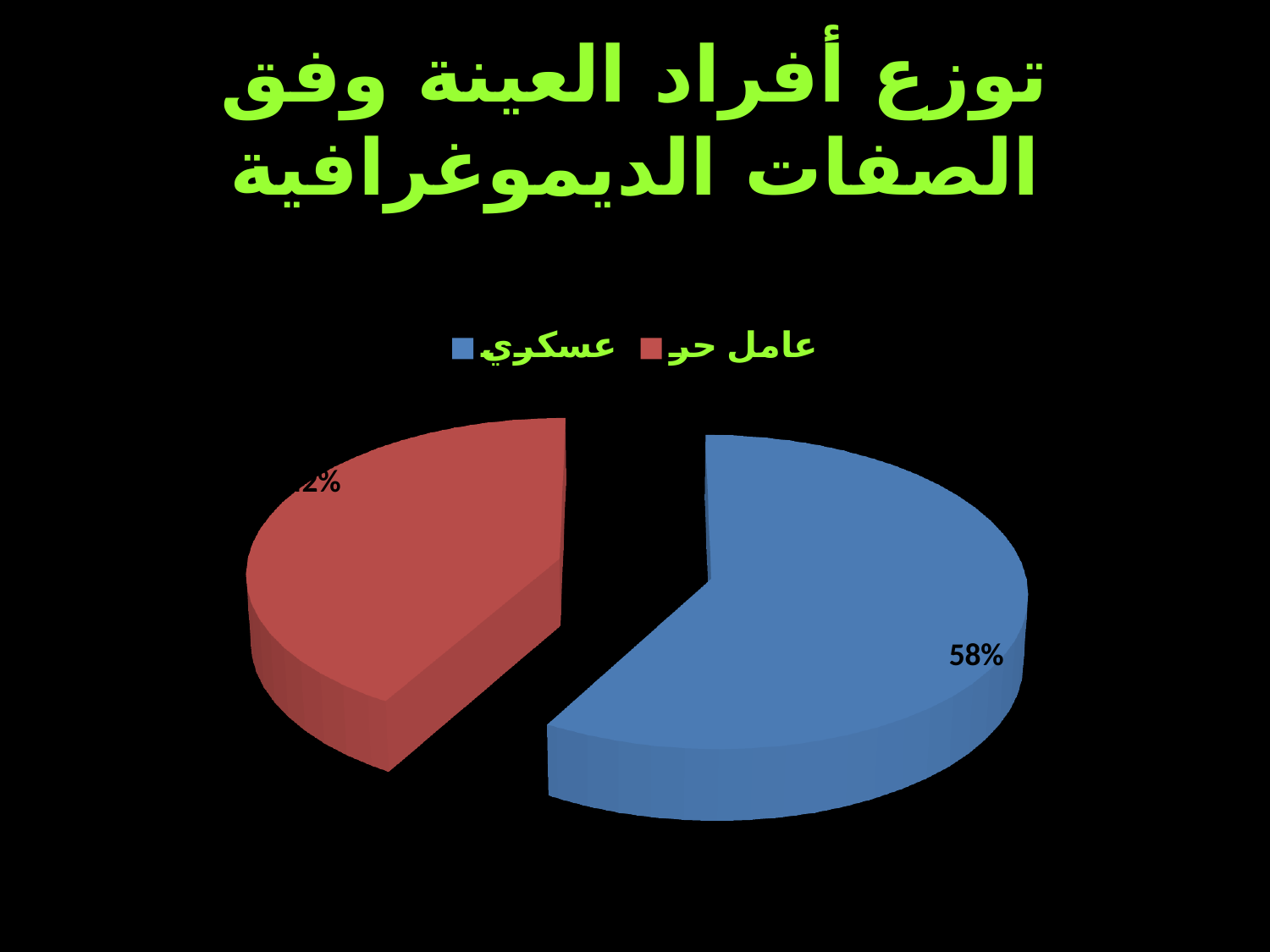
Which slice is larger, عسكري or عامل حر? عسكري Which category has the smallest slice of the pie? عامل حر What share of the pie is taken by عسكري? 58% What is the title of the slide? توزع أفراد العينة وفق الصفات الديموغرافية How many slices does the pie chart have? 2 What colour is the عسكري slice in the pie chart? blue Which category has the largest slice of the pie? عسكري What kind of chart is shown on the slide? pie chart Is the share for عسكري greater or less than 50%? greater Is the share for عامل حر greater or less than 50%? less How many entries does the legend list? 2 What percentage of the pie does the عسكري slice represent? 58%